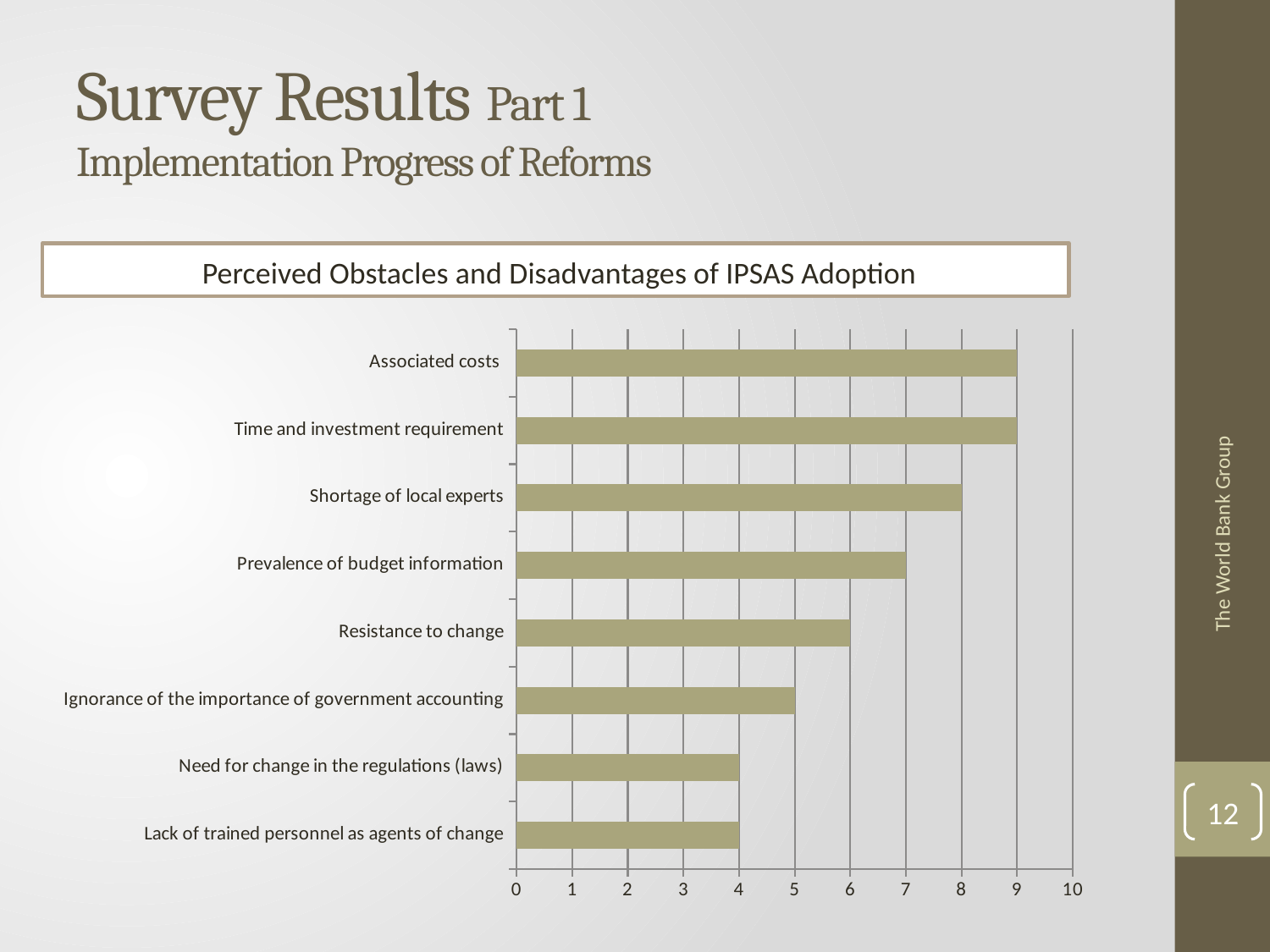
What is the value for Shortage of local experts? 8 What is the value for Prevalence of budget information? 7 What is the title of the chart? Perceived Obstacles and Disadvantages of IPSAS Adoption What is the value for Ignorance of the importance of government accounting? 5 Which category has the lowest value, Need for change in the regulations (laws) or Resistance to change? Need for change in the regulations (laws) What is the value for Resistance to change? 6 What kind of chart is shown on the slide? bar chart Is the value for Time and investment requirement greater or less than 5? greater What is the maximum value shown on the horizontal axis? 10 Which is larger, the value for Shortage of local experts or the value for Prevalence of budget information? Shortage of local experts What is the difference between the values for Associated costs and Lack of trained personnel as agents of change? 5 How many categories are plotted in the chart? 8